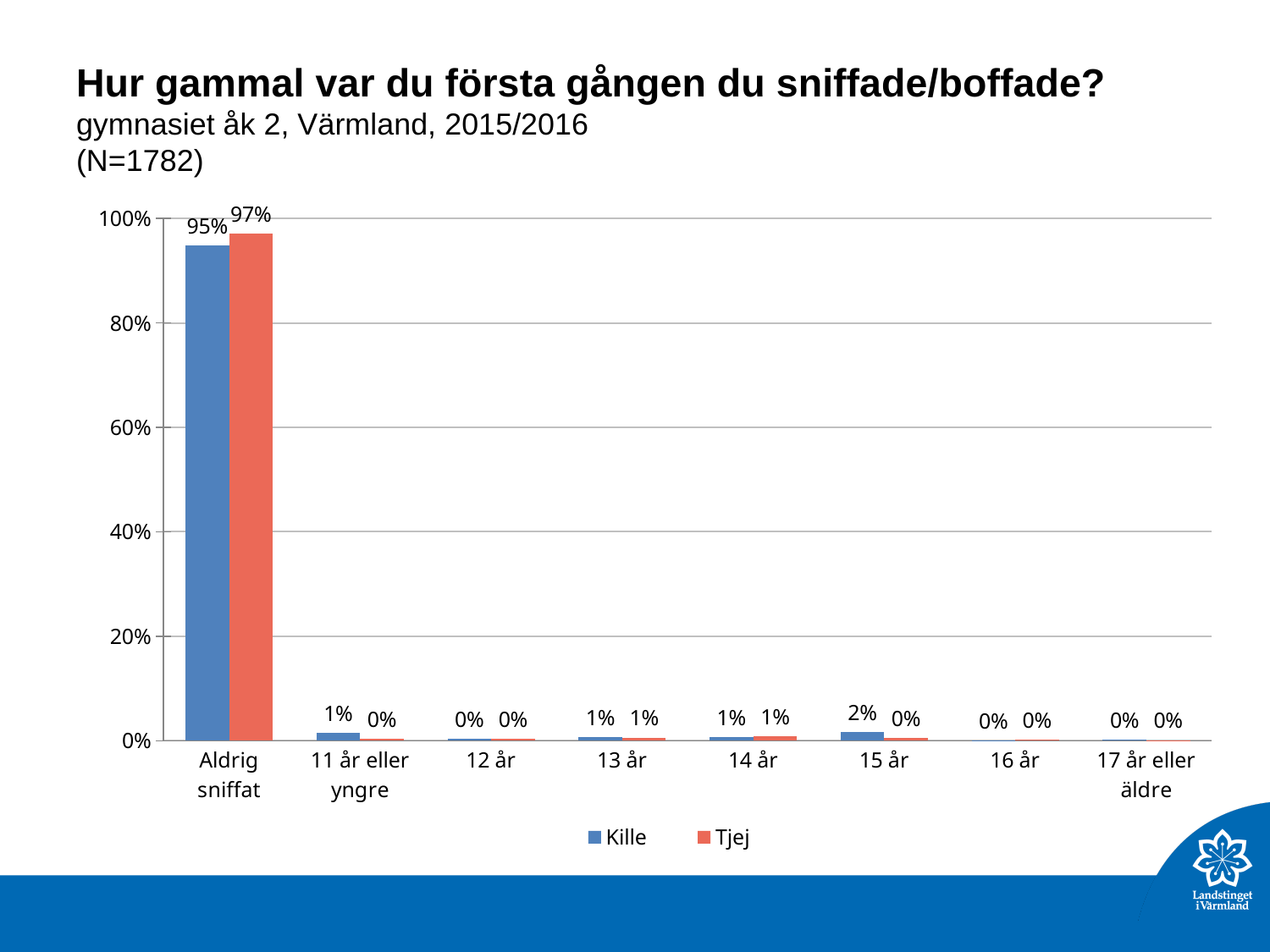
What is the value for Tjej in the 'Aldrig sniffat' category? 97% In the 'Aldrig sniffat' category, which series has the larger value, Kille or Tjej? Tjej What is the value for Kille in the 'Aldrig sniffat' category? 95% What is the difference between the Tjej and Kille values in the 'Aldrig sniffat' category? 2% What is the value for Kille in the '15 år' category? 2% How many categories are shown on the x axis? 8 Which category has the highest value for Kille? Aldrig sniffat What kind of chart is shown on the slide? Bar chart Is the value for Kille in the 'Aldrig sniffat' category greater or less than 80%? greater What is the value for Tjej in the '14 år' category? 1% What are the names of the two series in the legend? Kille and Tjej How many series does the legend list? 2